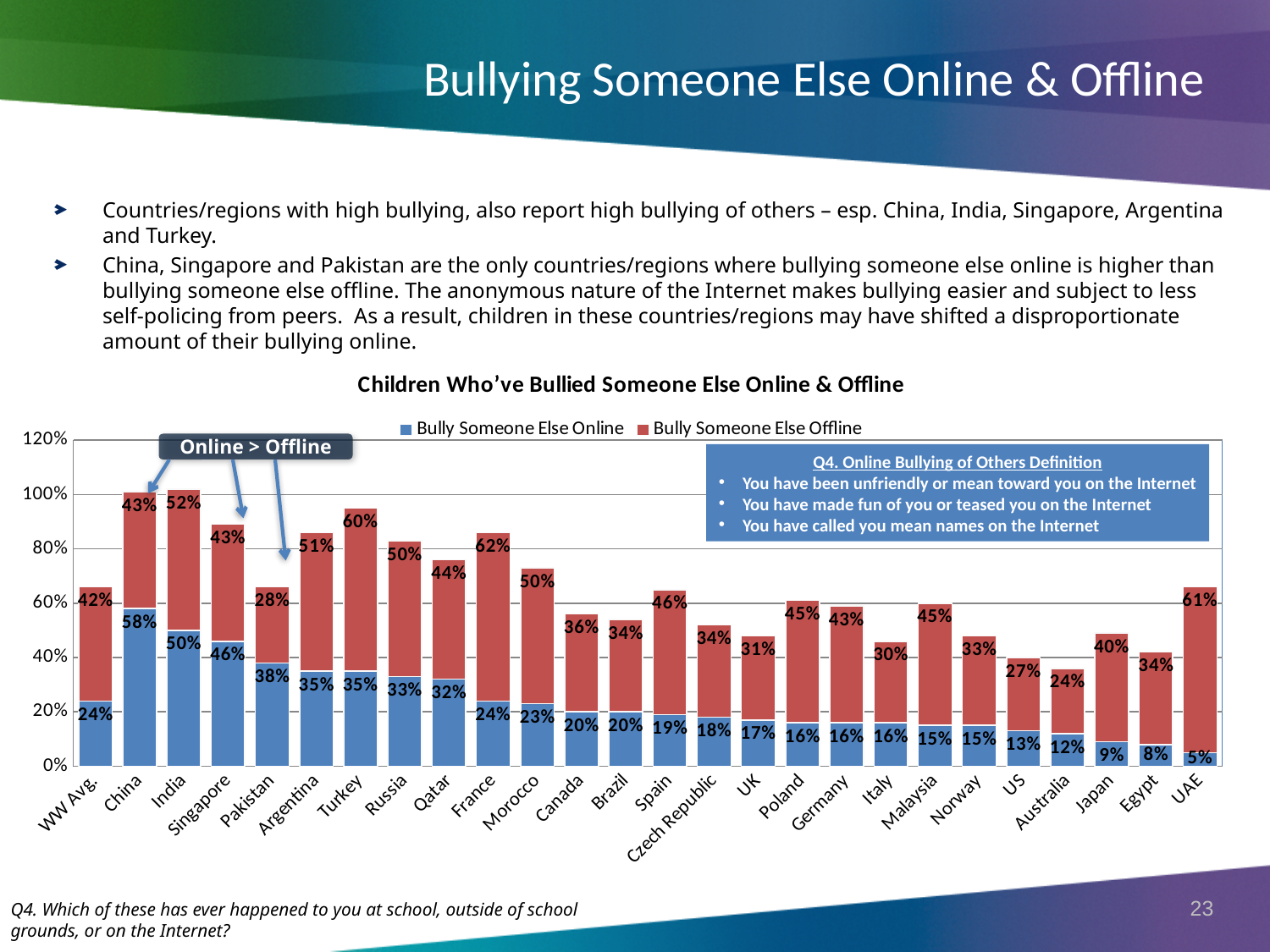
Which country/region has the lowest value for 'Bully Someone Else Offline'? Australia What type of chart is used to show the bullying data? Stacked bar chart How many countries/regions (including WW Avg) are shown on the x axis? 26 What is the value for 'Bully Someone Else Offline' for France? 62% What percentage of children in China report bullying someone else online? 58% For Turkey, how much higher is the offline bullying value than the online bullying value? 25% How many series does the legend list? 2 For Pakistan, which is larger: the online bullying value or the offline bullying value? Online Which colour represents 'Bully Someone Else Online' in the chart? Blue Which country/region has the highest value for 'Bully Someone Else Online'? China What is the combined total of the online and offline values for India? 102% Which country/region has the lowest value for 'Bully Someone Else Online'? UAE